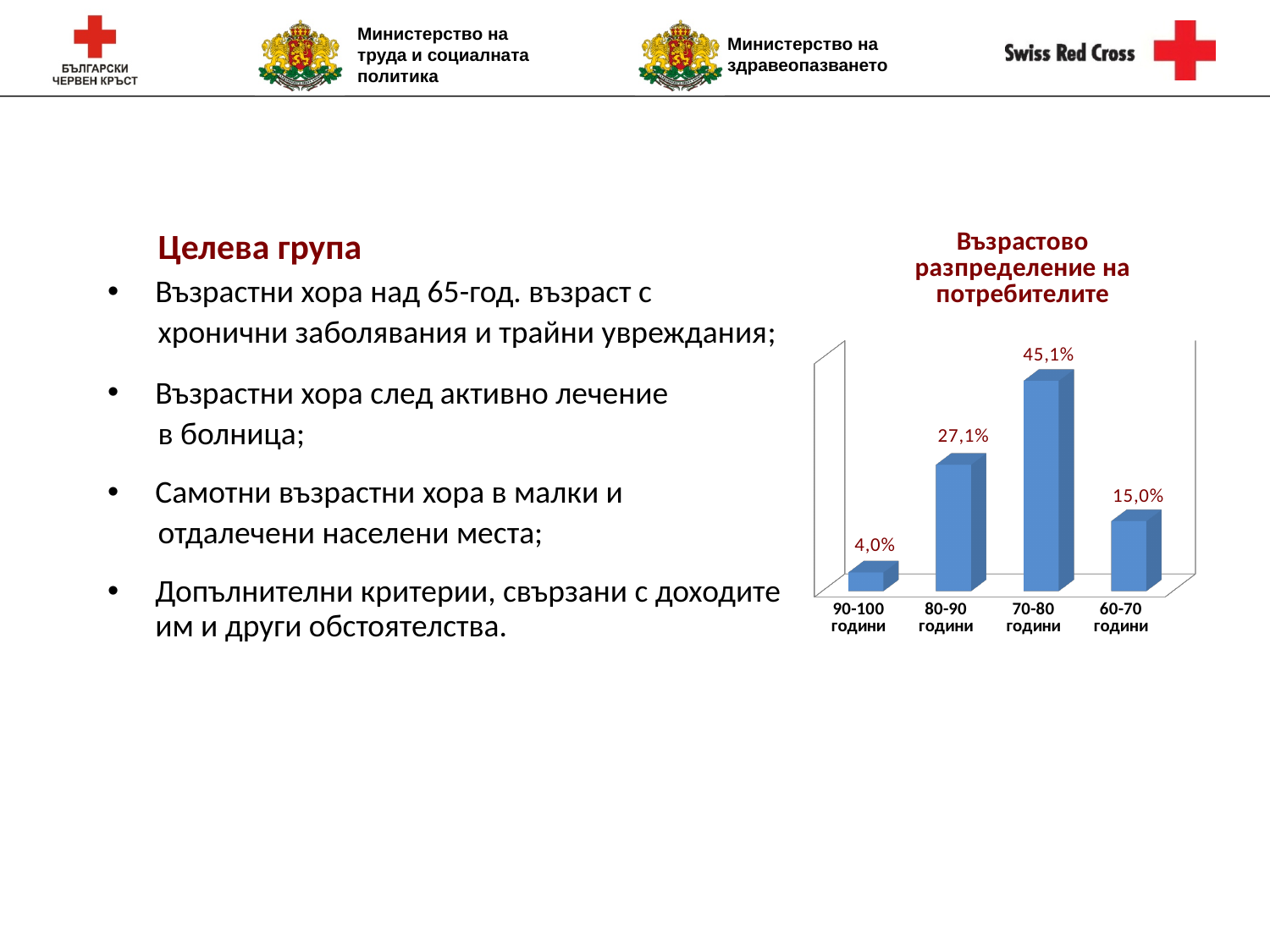
What is the difference between the values for 70-80 години and 80-90 години? 18,0% How many age categories are shown in the chart? 4 What is the difference between the values for 60-70 години and 90-100 години? 11,0% What is the value for the 60-70 години category? 15,0% What kind of chart is shown on the slide? bar chart What is the value for the 80-90 години category? 27,1% What is the value for the 70-80 години category? 45,1% What is the value for the 90-100 години category? 4,0% What is the title of the chart? Възрастово разпределение на потребителите Which is larger, the value for 80-90 години or the value for 60-70 години? 80-90 години Which age group has the highest value? 70-80 години Which age group has the lowest value? 90-100 години